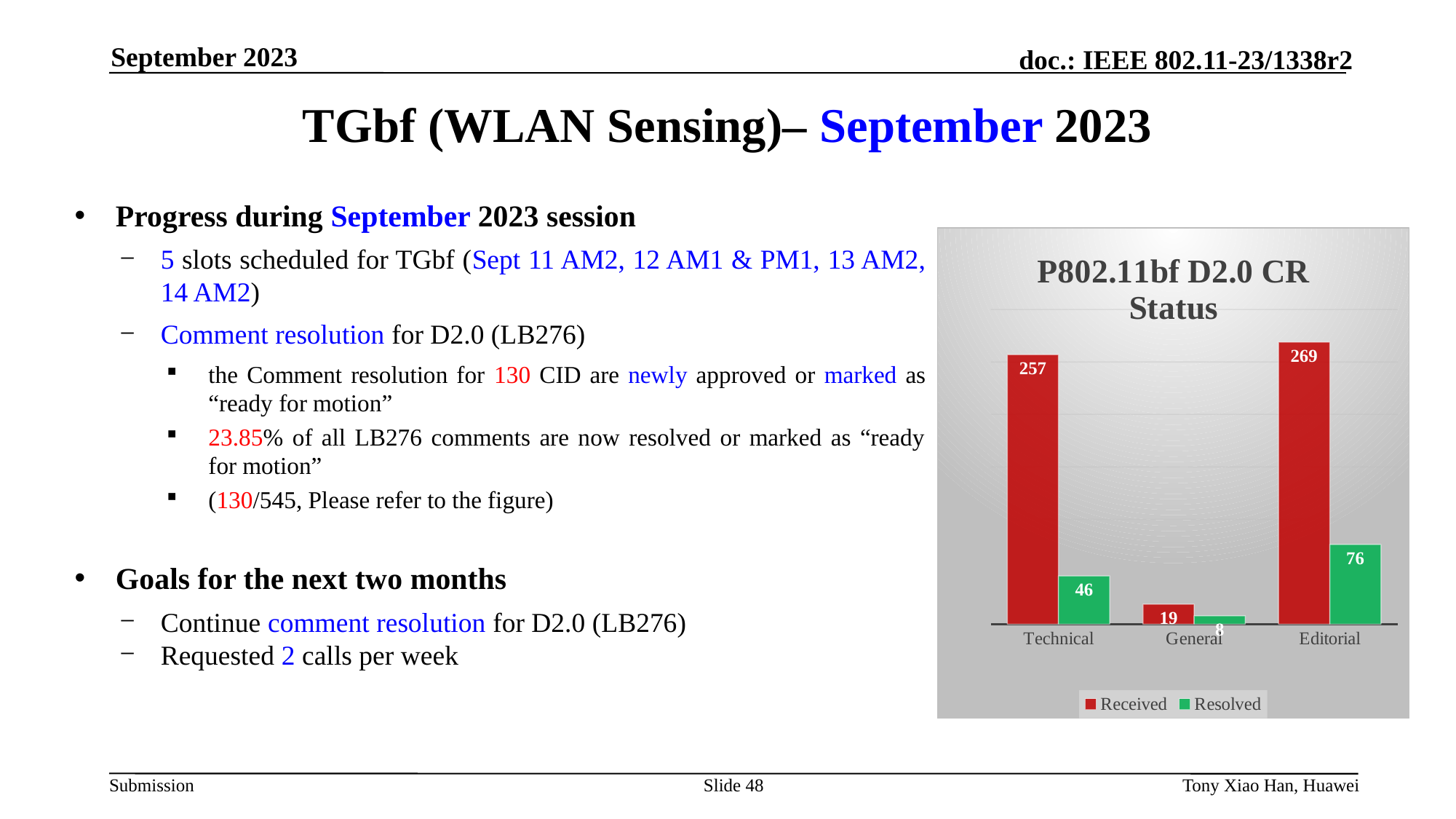
What type of chart is shown on the slide? bar chart How many series does the chart legend list? 2 How many categories are shown on the x axis of the chart? 3 Which category has the lowest Resolved value? General Which is larger, the Resolved value for Editorial or the Resolved value for Technical? Editorial Which category has the highest Received value? Editorial What is the title of the chart? P802.11bf D2.0 CR Status What is the Received value for Technical? 257 What is the Resolved value for Editorial? 76 What is the difference between the Received values for Editorial and Technical? 12 What is the Resolved value for Technical? 46 What is the Received value for General? 19